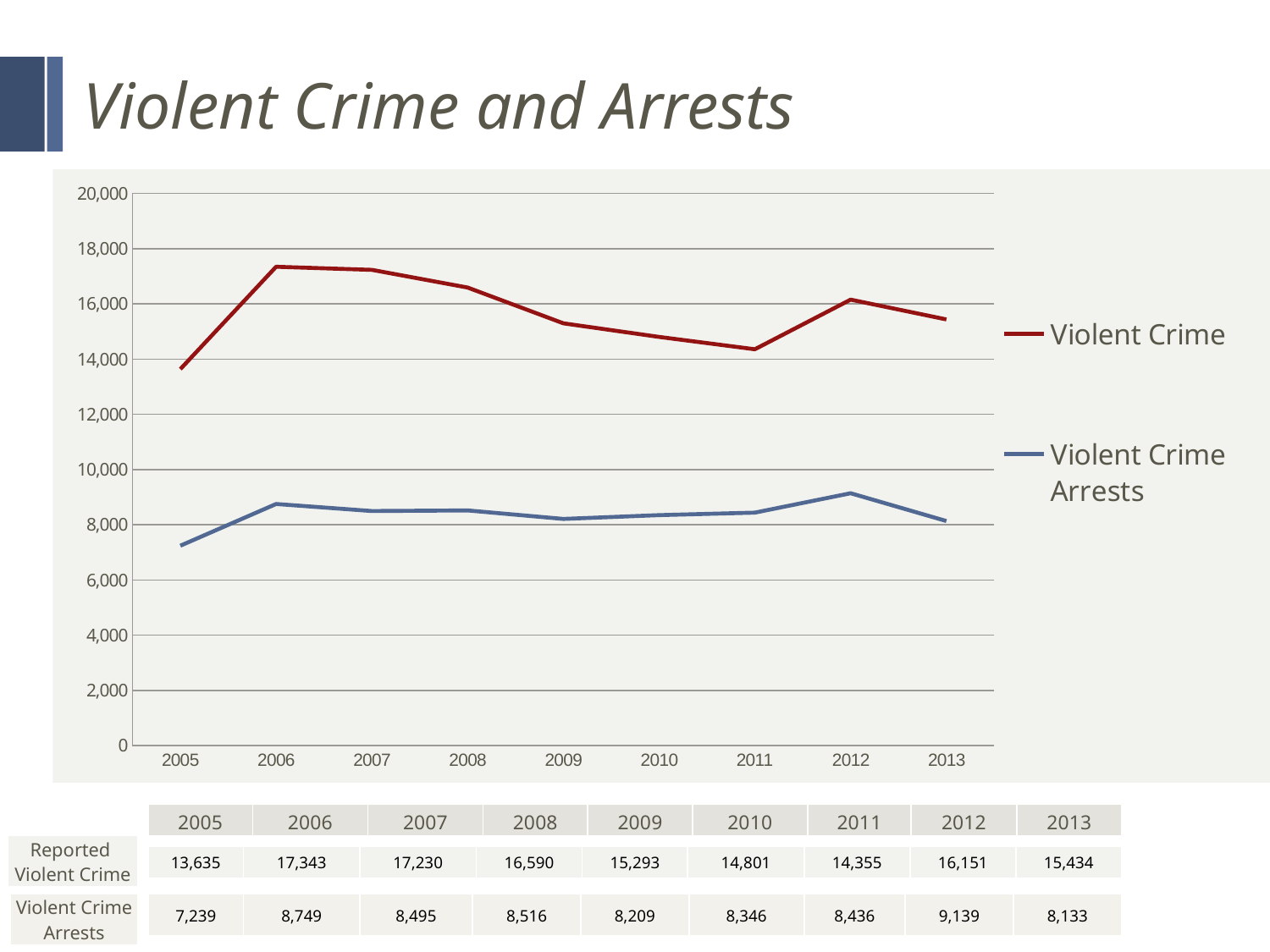
How many series does the legend list? 2 Is the Reported Violent Crime value for 2011 greater or less than 16,000? less In which year was Reported Violent Crime highest? 2006 How many years are plotted along the x axis? 9 Did Reported Violent Crime rise or fall from 2006 to 2011? fall What was the Reported Violent Crime value in 2006? 17,343 What colour is the Violent Crime line? dark red What was the Violent Crime Arrests value in 2012? 9,139 In which year was Violent Crime Arrests lowest? 2005 What type of chart is shown on the slide? line chart Which year had more Violent Crime Arrests, 2006 or 2009? 2006 What is the difference between Reported Violent Crime and Violent Crime Arrests in 2013? 7,301